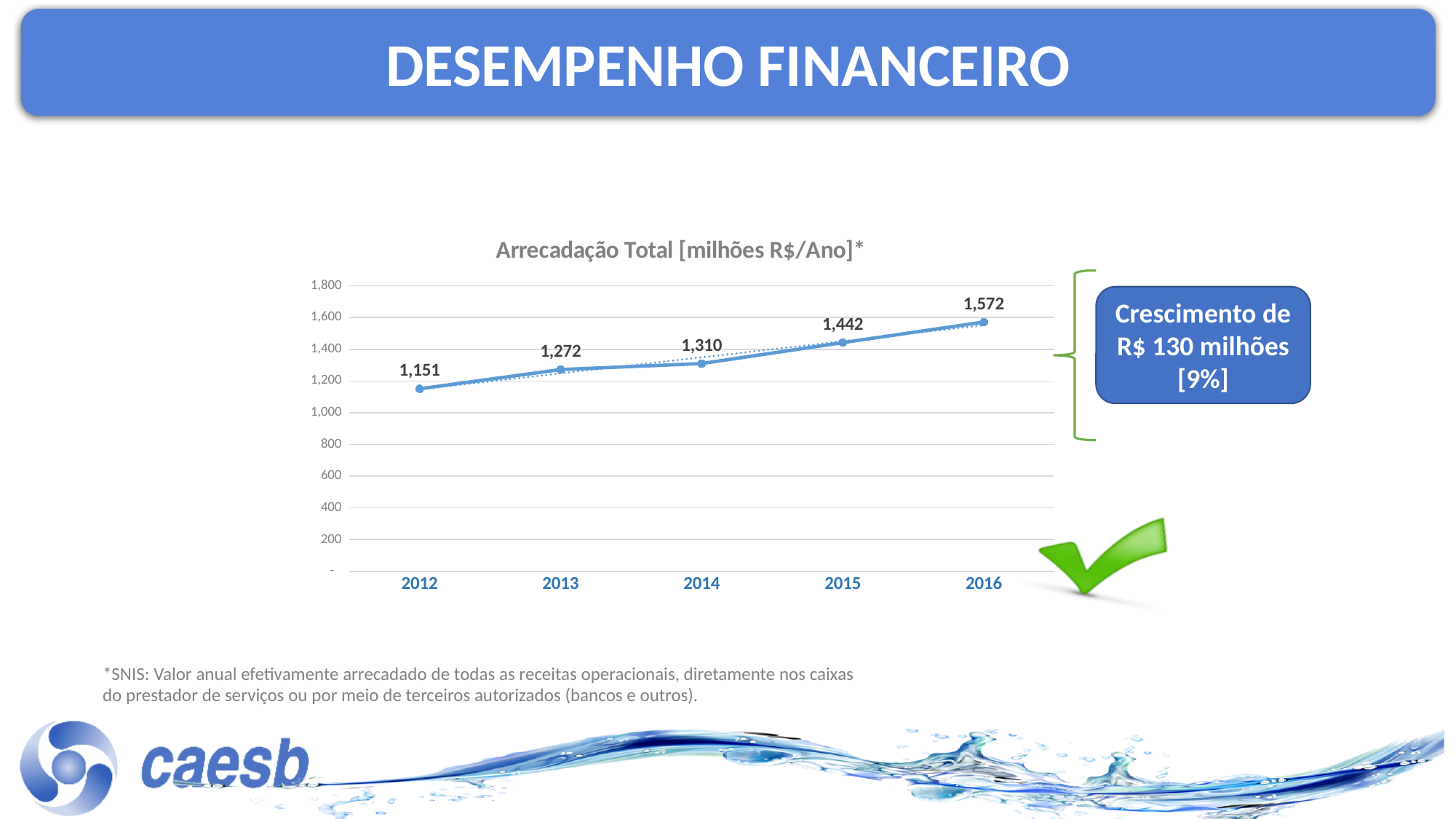
What is the value for 2012? 1,151 Do the values rise or fall from 2012 to 2016? rise Which year has the highest value? 2016 How many years are plotted on the chart? 5 What is the difference between the values for 2013 and 2012? 121 What is the value for 2016? 1,572 Which year has the lowest value? 2012 What is the difference between the values for 2016 and 2015? 130 Which is larger, the value for 2014 or the value for 2015? 2015 Is the value for 2013 greater or less than 1,200? greater What is the value for 2014? 1,310 What kind of chart is shown? line chart